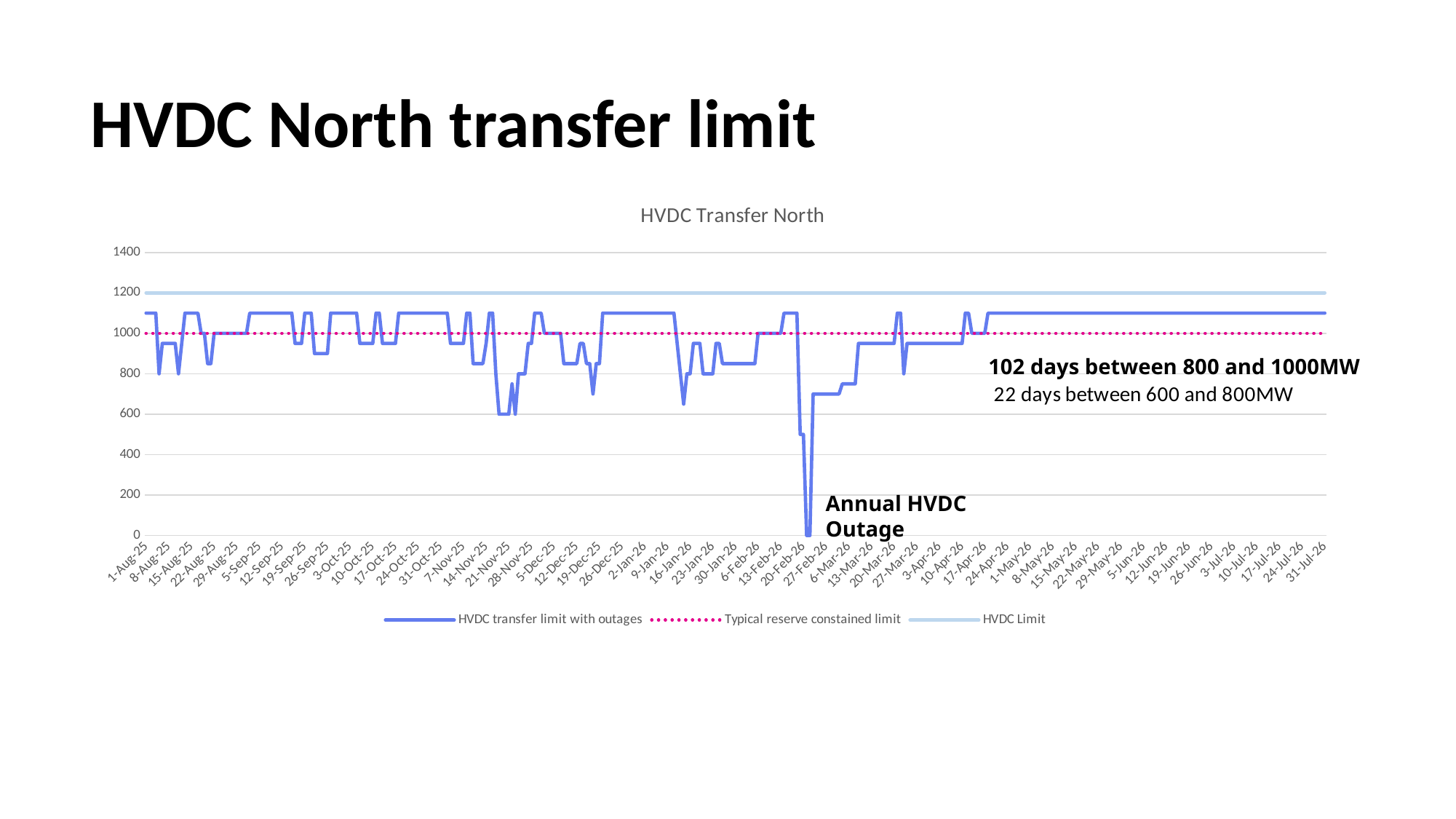
Is the HVDC transfer limit with outages on 27-Feb-26 greater or less than 200? greater According to the annotation on the chart, how many days were between 800 and 1000MW? 102 days How many series does the chart legend list? 3 What is the title of the chart? HVDC Transfer North Which series reaches the lowest value on the chart? HVDC transfer limit with outages What kind of chart is shown on the slide? Line chart Is the HVDC transfer limit with outages on 1-May-26 greater or less than 1000? greater Is the HVDC transfer limit with outages on 6-Mar-26 greater or less than 800? less What value does the HVDC Limit series sit at throughout the chart? 1200 What value does the Typical reserve constained limit series sit at throughout the chart? 1000 What is the difference between the HVDC Limit and the Typical reserve constained limit? 200 Which is higher, the HVDC Limit or the Typical reserve constained limit? HVDC Limit